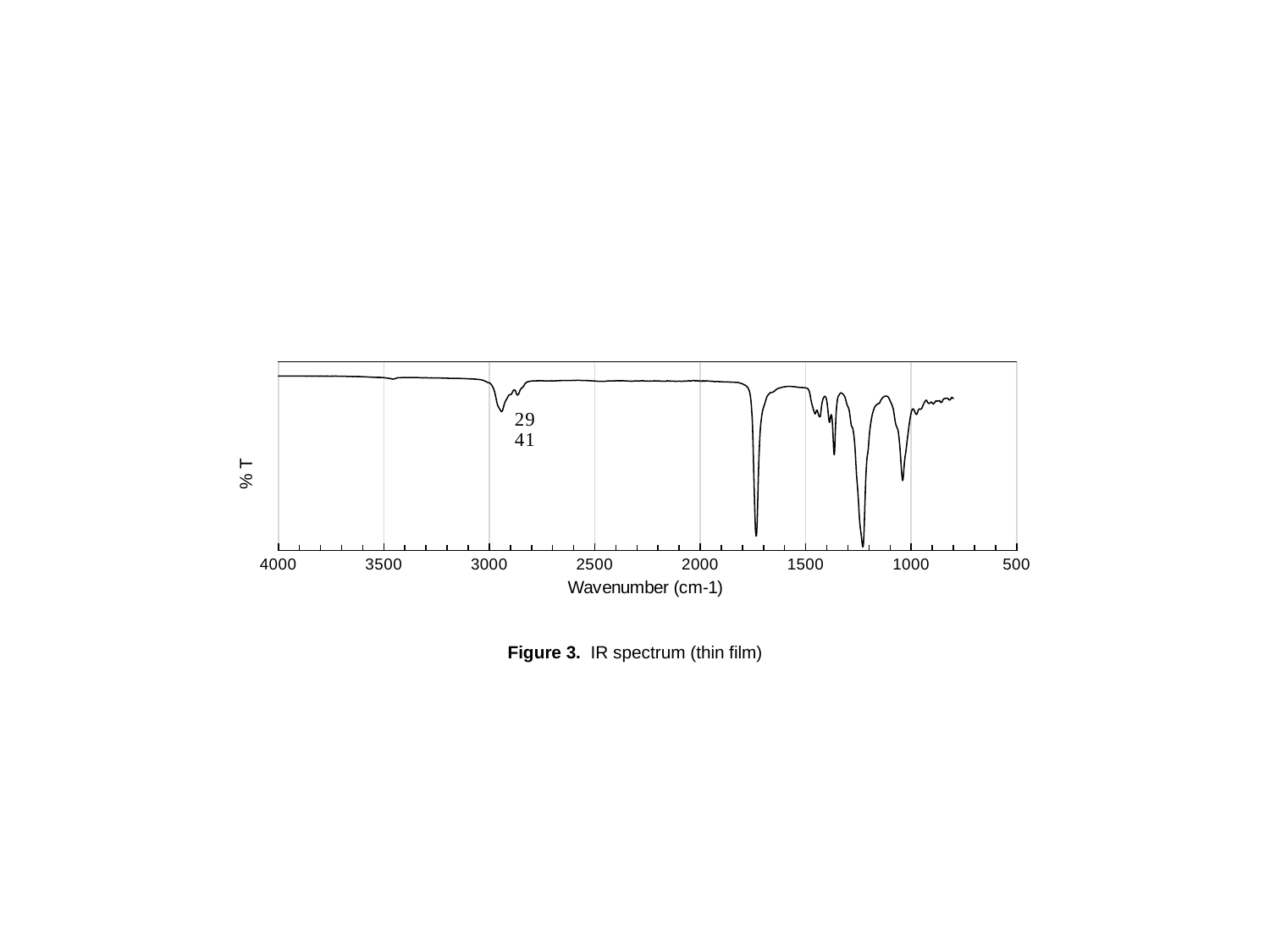
Which reaches a lower % T: the sharp trough between 2000 and 1500 cm-1 or the trough just above 1000 cm-1? the trough between 2000 and 1500 cm-1 How many labelled tick values are shown on the x axis? 8 How many data series (lines) are plotted on the chart? 1 What is the caption printed below the chart? Figure 3. IR spectrum (thin film) What is the title of the x axis of the chart? Wavenumber (cm-1) What is the title of the y axis of the chart? % T What wavenumber value is printed as a label next to the absorption band just below 3000 cm-1? 2941 Is the wavenumber of the sharp absorption trough between the 2000 and 1500 tick marks greater or less than 1500? greater What is the rightmost labelled value on the x axis? 500 What kind of chart is shown on the slide? line chart Is the wavenumber of the deepest absorption trough greater or less than 1500? less What is the leftmost labelled value on the x axis? 4000